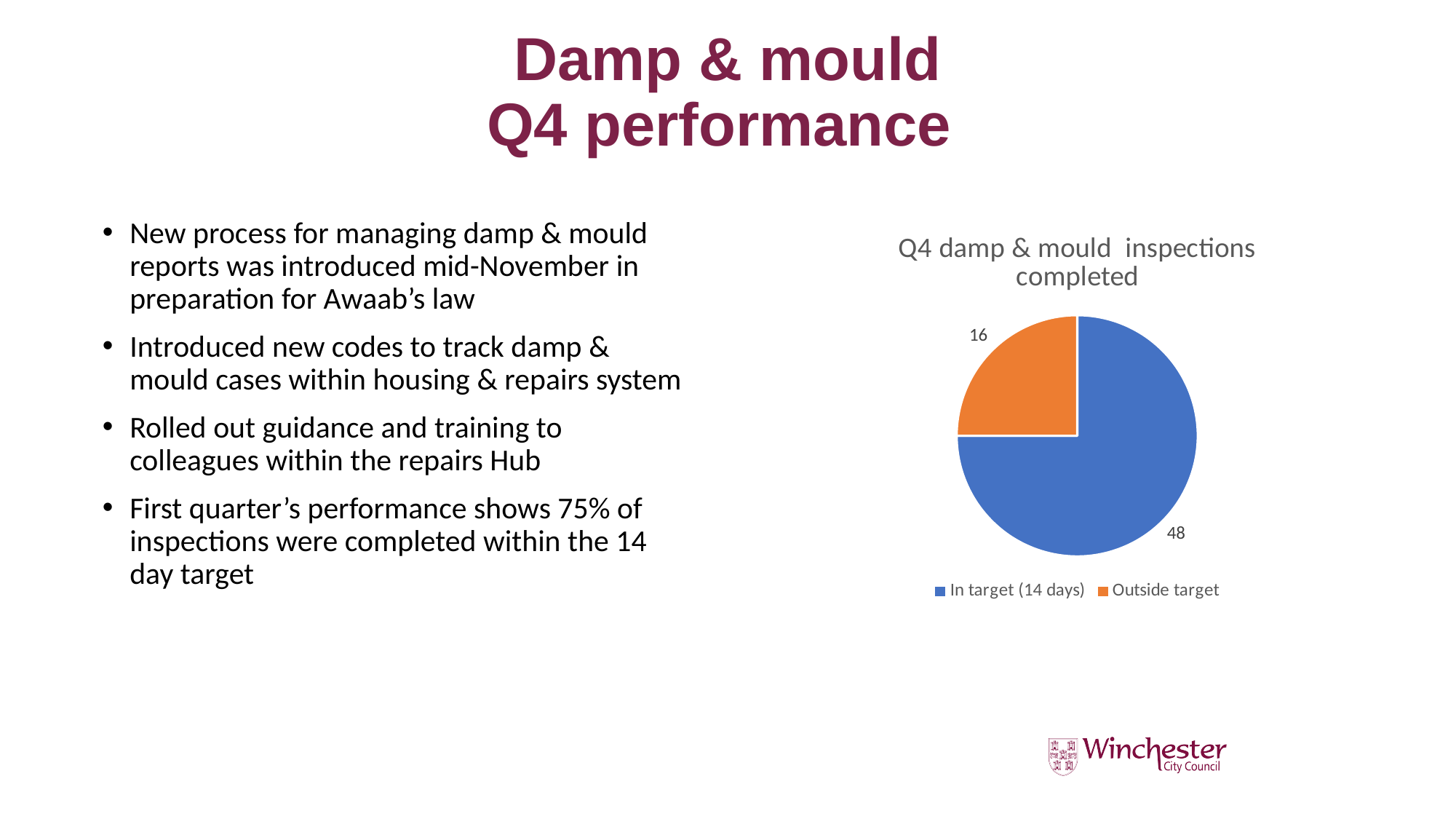
How many categories does the pie chart show? 2 How many inspections were completed in target (14 days)? 48 Which is larger: the number of inspections in target (14 days) or outside target? In target (14 days) What is the total number of inspections shown in the pie chart? 64 What colour is the Outside target slice? Orange Which category has the largest slice of the pie? In target (14 days) What is the title of the chart? Q4 damp & mould inspections completed What is the difference between the number of inspections in target and outside target? 32 What type of chart is shown on the slide? Pie chart What share of the pie does the In target (14 days) slice represent? 75% How many inspections were completed outside target? 16 Which category has the smallest slice of the pie? Outside target